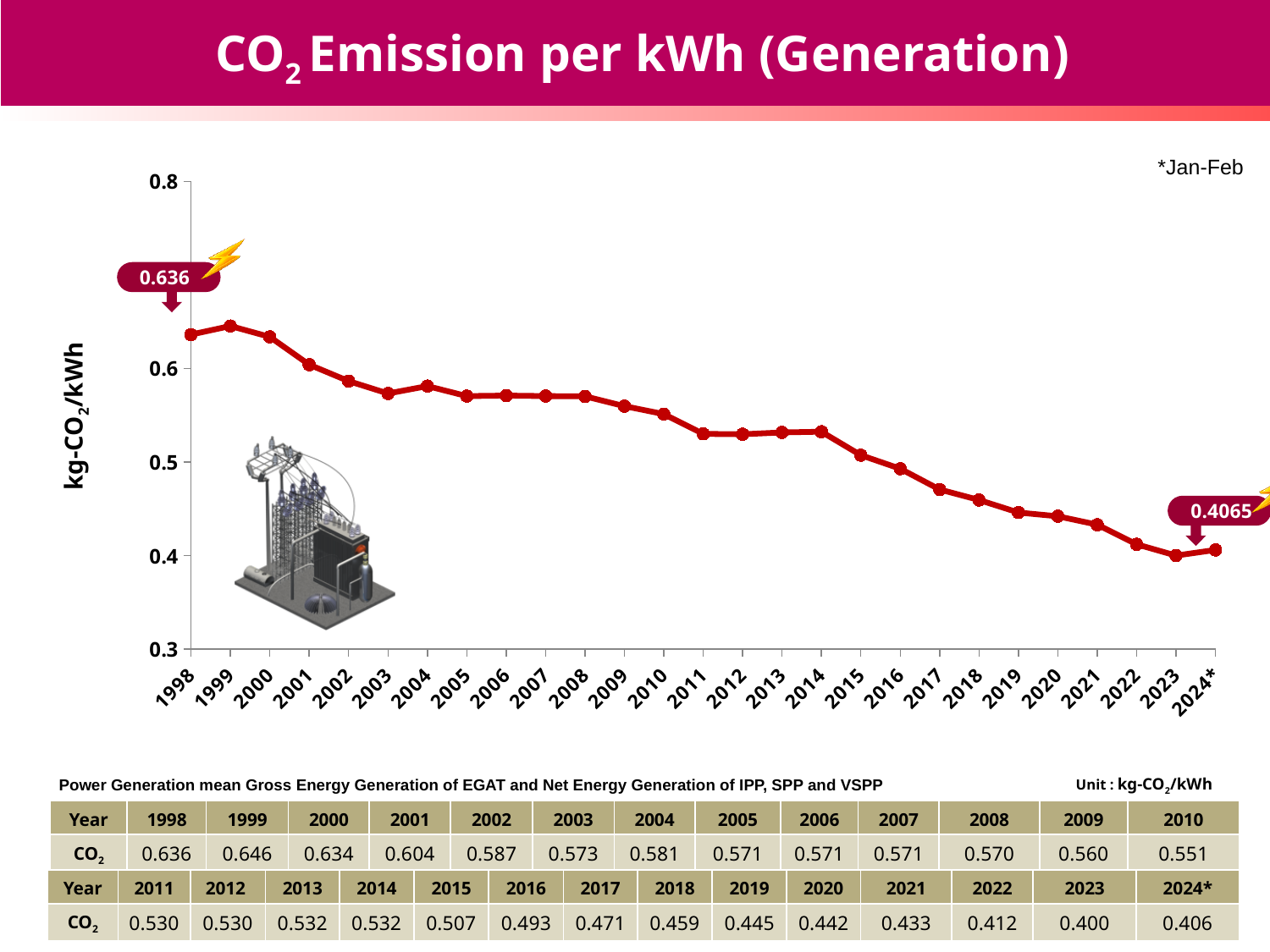
What is the CO2 emission per kWh for 2015? 0.507 Which year has the larger CO2 emission per kWh, 2003 or 2004? 2004 What kind of chart is shown on the slide? line chart What is the CO2 emission per kWh for 2023? 0.400 Is the value for 2010 greater or less than 0.5? greater Which year has the lowest CO2 emission per kWh? 2023 What is the CO2 emission per kWh for 1998? 0.636 Do the values generally rise or fall from 1998 to 2023? fall What is the difference between the CO2 emission per kWh in 1998 and in 2023? 0.236 Which year has the highest CO2 emission per kWh? 1999 What unit is shown on the y axis of the chart? kg-CO2/kWh How many years are plotted on the chart? 27